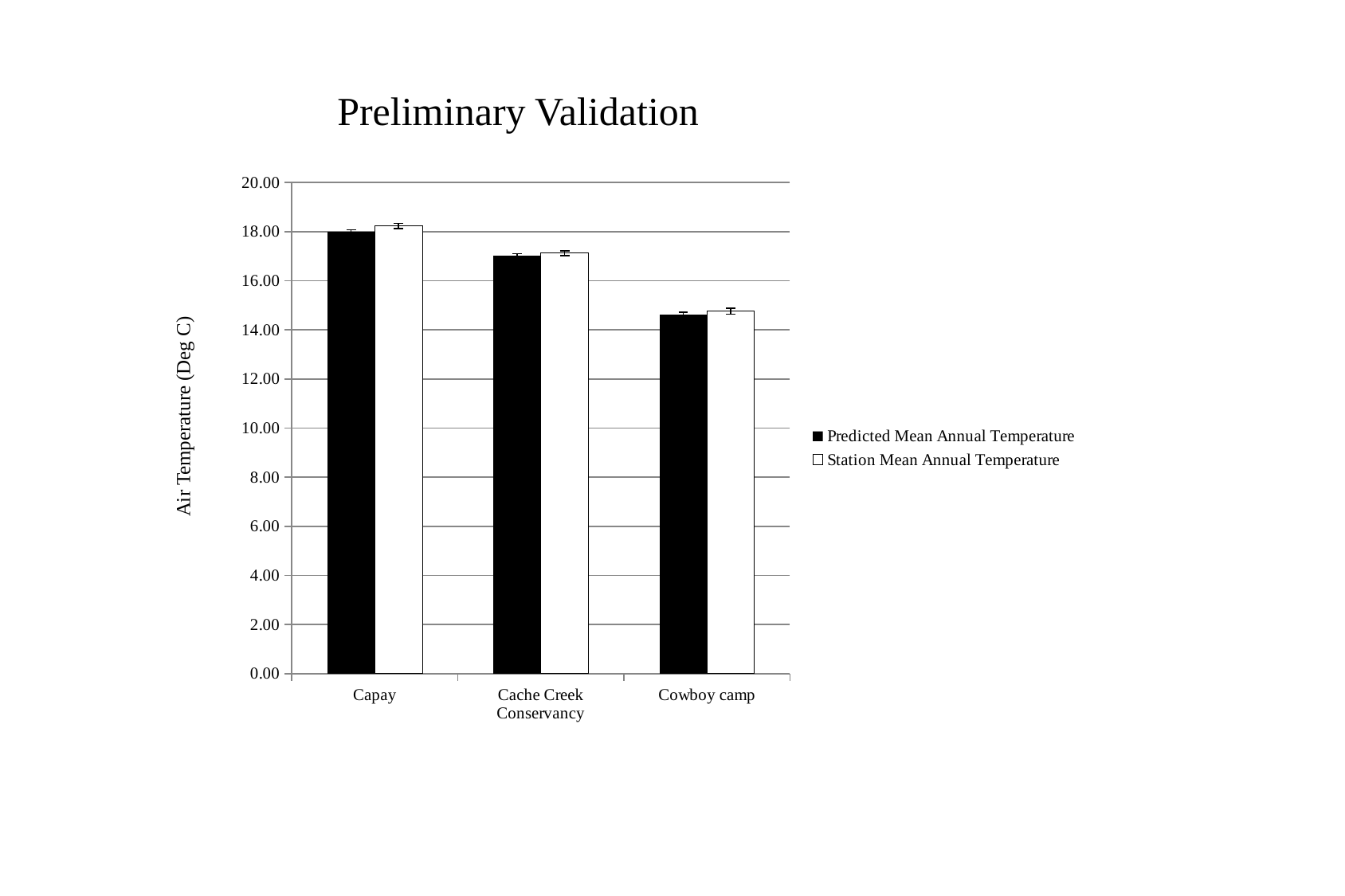
Which has a larger Predicted Mean Annual Temperature, Capay or Cowboy camp? Capay Is the Predicted Mean Annual Temperature for Capay greater or less than 16.00? greater What kind of chart is shown on the slide? bar chart Do the Predicted Mean Annual Temperature values rise or fall from left to right across the categories? fall Which category has the lowest Station Mean Annual Temperature? Cowboy camp Is the Station Mean Annual Temperature for Cache Creek Conservancy greater or less than 18.00? less What is the label of the vertical axis? Air Temperature (Deg C) Which category has the highest Predicted Mean Annual Temperature? Capay How many categories are shown on the x axis? 3 How many series does the legend list? 2 What is the title of the chart? Preliminary Validation Is the Predicted Mean Annual Temperature for Cowboy camp greater or less than 16.00? less